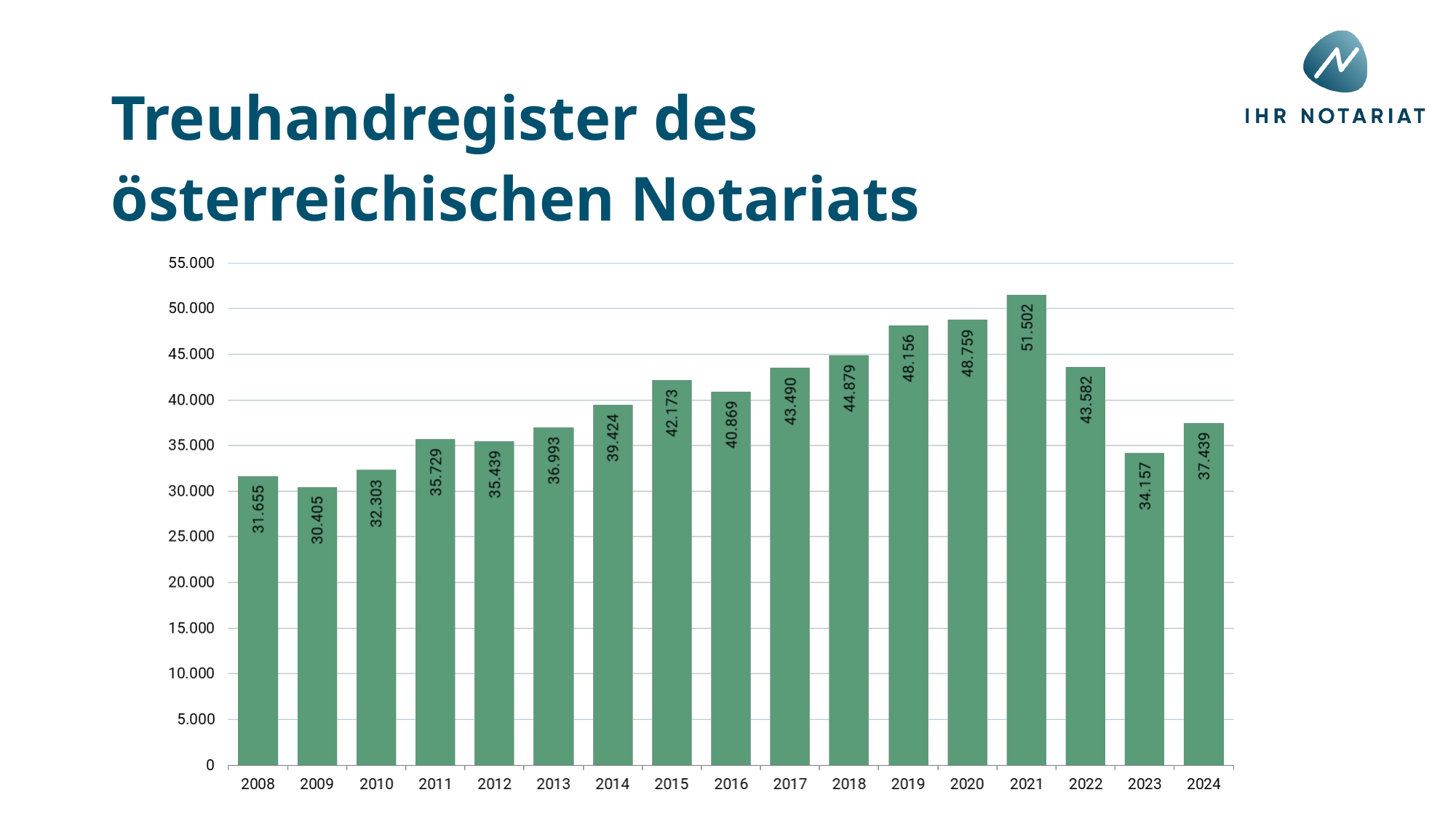
Which is larger, the value for 2015 or the value for 2016? 2015 How many years are shown on the x axis? 17 Which year has the highest value? 2021 What kind of chart is shown on the slide? bar chart What is the value for 2008? 31.655 Which year has the lowest value? 2009 Is the value for 2019 greater or less than 45.000? greater What is the value for 2024? 37.439 What is the title of the slide? Treuhandregister des österreichischen Notariats Do the values rise or fall from 2021 to 2023? fall What is the value for 2021? 51.502 What is the difference between the values for 2021 and 2022? 7.920